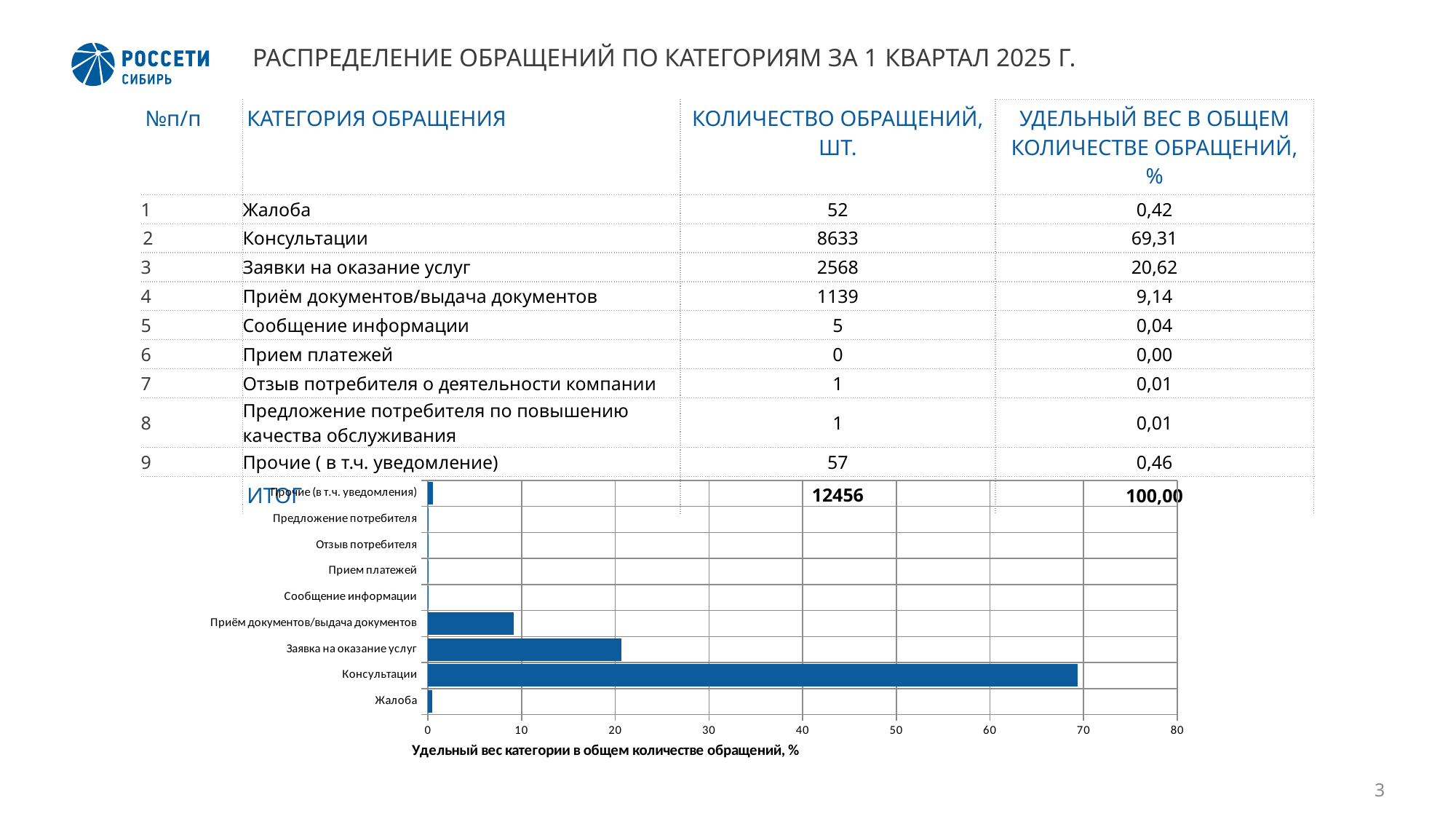
Which is larger in the chart: Консультации or Заявка на оказание услуг? Консультации Is the value for Приём документов/выдача документов in the chart greater or less than 10? less Which is larger in the chart: Заявка на оказание услуг or Приём документов/выдача документов? Заявка на оказание услуг Is the value for Заявка на оказание услуг in the chart greater or less than 30? less What is the title of the horizontal axis of the chart? Удельный вес категории в общем количестве обращений, % What is the share (%) for Заявки на оказание услуг as printed on the slide? 20,62 Is the value for Консультации in the chart greater or less than 60? greater What kind of chart is shown on the slide? bar chart Which category has the longest bar in the chart? Консультации How many categories (bars) does the chart show? 9 What is the share (%) for Консультации as printed on the slide? 69,31